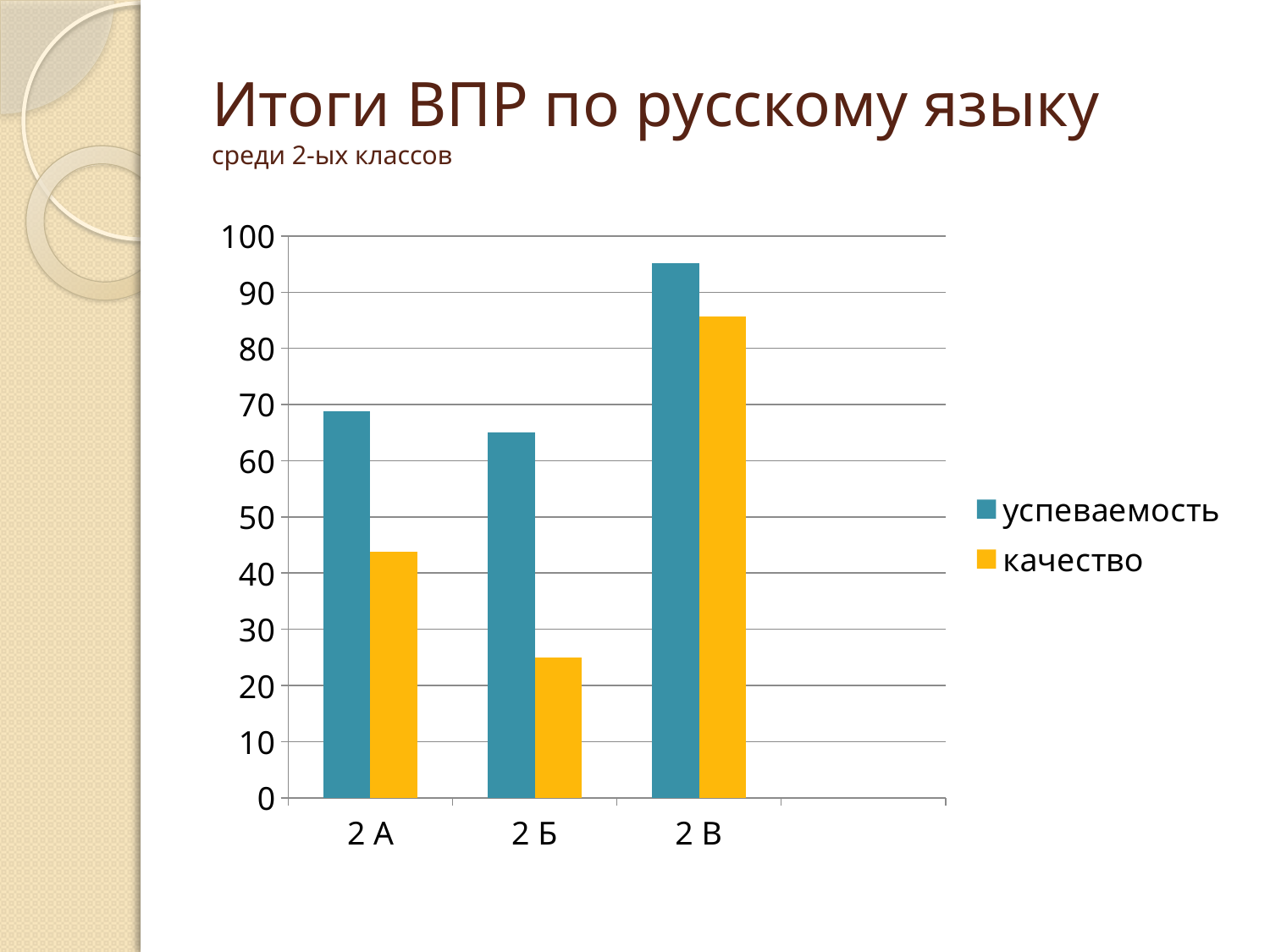
Which class has the lowest качество value? 2 Б What colour are the bars for the качество series? yellow Is the успеваемость value for 2 А greater or less than 60? greater Which is larger: the качество value for 2 А or the качество value for 2 В? 2 В Which class has the highest успеваемость value? 2 В What kind of chart is shown on the slide? bar chart Is the качество value for 2 Б greater or less than 30? less How many series does the legend list? 2 Is the успеваемость value for 2 В greater or less than 90? greater How many classes (categories) are shown on the x axis? 3 Which class has the lowest успеваемость value? 2 Б